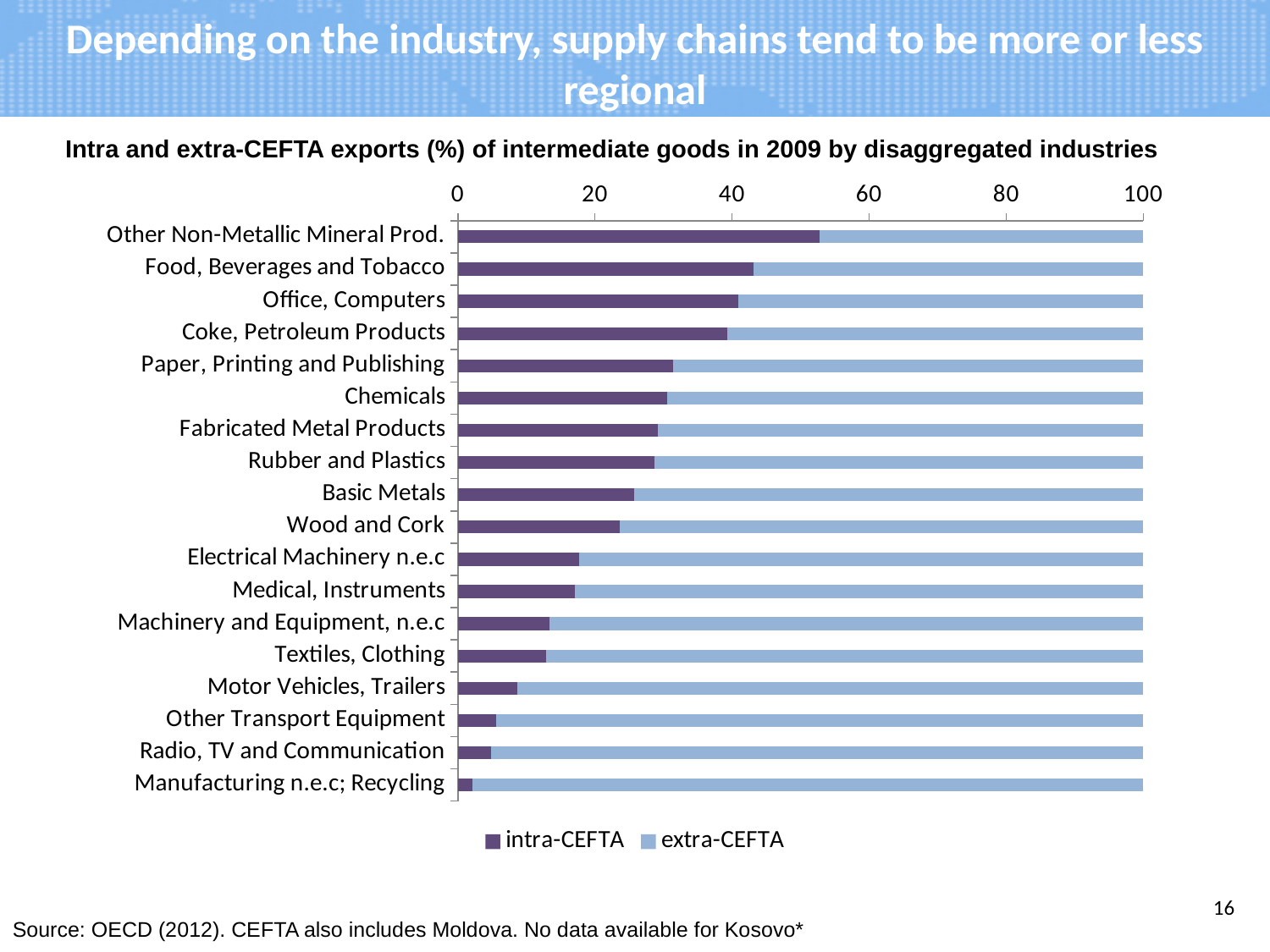
Is the intra-CEFTA value for Other Non-Metallic Mineral Prod. greater or less than 40? greater Is the intra-CEFTA value for Motor Vehicles, Trailers greater or less than 20? less Which has a larger intra-CEFTA share, Coke, Petroleum Products or Basic Metals? Coke, Petroleum Products Which has a larger extra-CEFTA share, Wood and Cork or Medical, Instruments? Medical, Instruments What kind of chart is shown on the slide? Stacked horizontal bar chart How many industries are listed on the chart? 18 Is the intra-CEFTA value for Chemicals greater or less than 40? less Which industry has the highest intra-CEFTA share? Other Non-Metallic Mineral Prod. What are the two series named in the legend? intra-CEFTA and extra-CEFTA How many series does the legend list? 2 What is the total of each stacked bar on the chart? 100 Which industry has the lowest intra-CEFTA share? Manufacturing n.e.c; Recycling